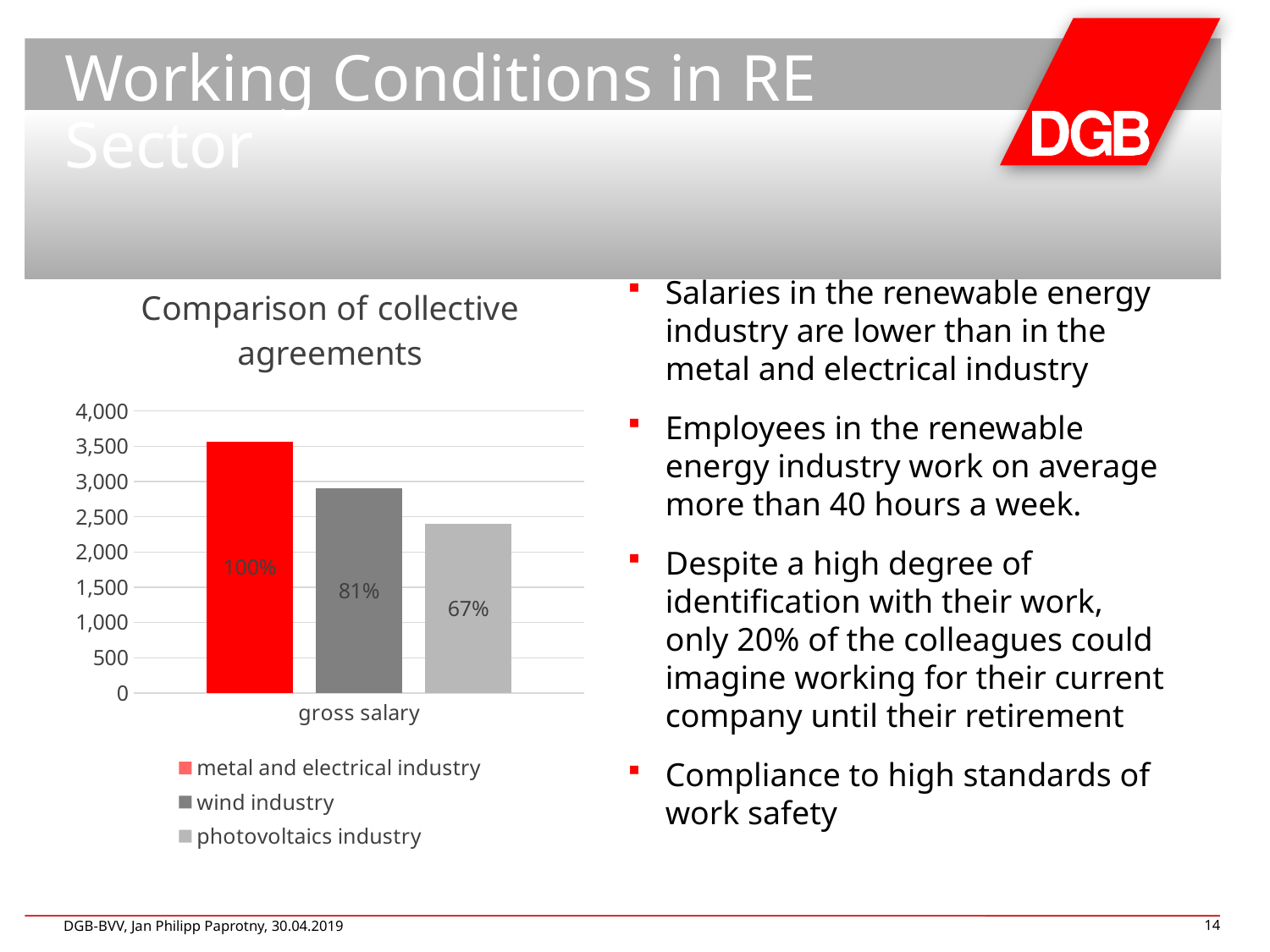
How many series does the chart legend list? 3 What is the data label shown on the bar for the wind industry? 81% Which industry has the lowest gross salary bar in the chart? photovoltaics industry Which industry has the highest gross salary bar in the chart? metal and electrical industry What is the category label shown on the x axis of the chart? gross salary Which bar is taller: wind industry or photovoltaics industry? wind industry What is the data label shown on the bar for the metal and electrical industry? 100% What is the title of the chart on the slide? Comparison of collective agreements Is the gross salary bar for the photovoltaics industry greater or less than 2,500? less Is the gross salary bar for the metal and electrical industry greater or less than 3,000? greater What is the data label shown on the bar for the photovoltaics industry? 67% What type of chart is shown under the title "Comparison of collective agreements"? bar chart